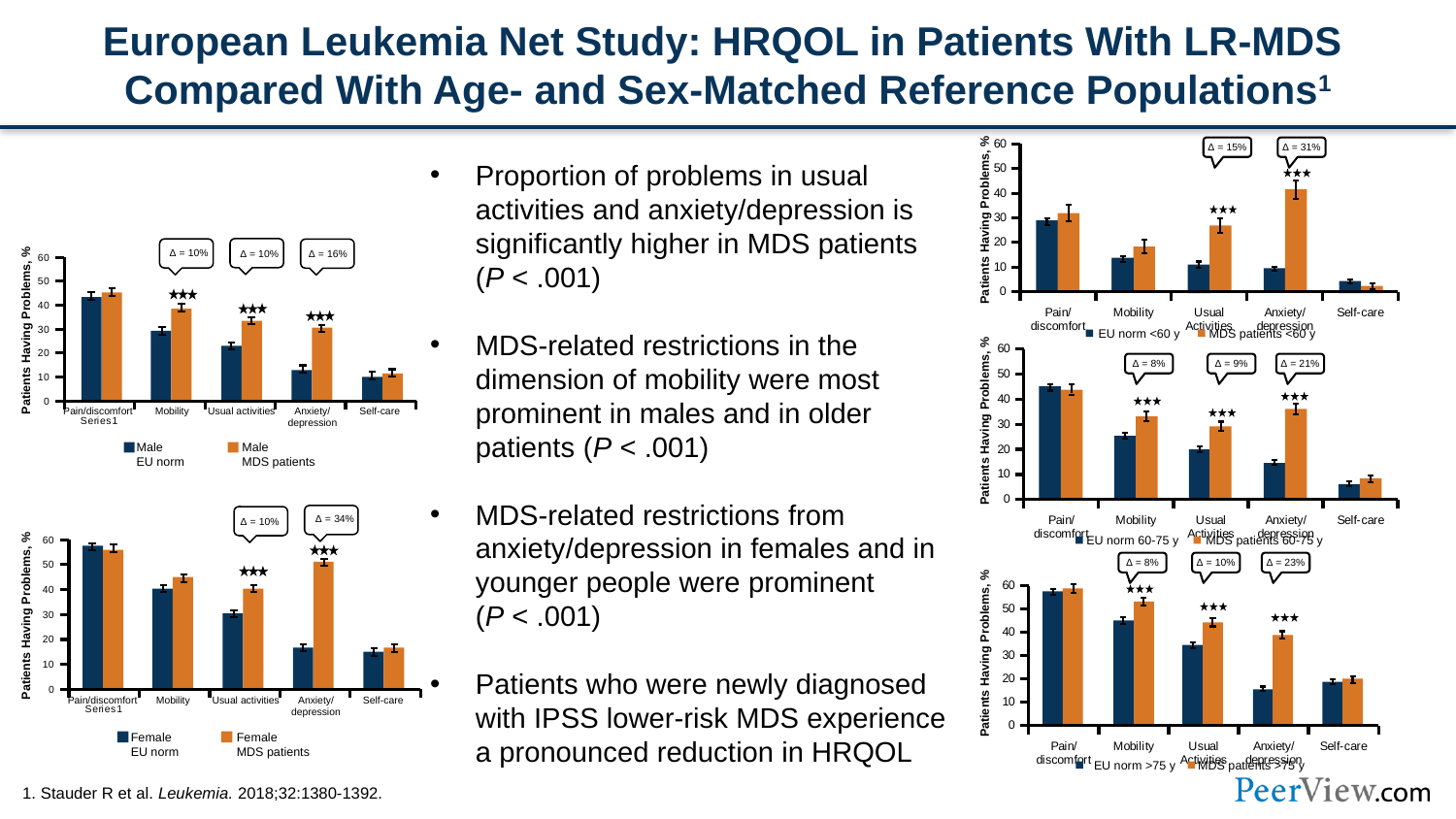
In the top-left chart (Male), is the value for Male MDS patients in Usual activities greater or less than 20? greater In the bottom-left chart (Female), which is larger for Usual activities: Female EU norm or Female MDS patients? Female MDS patients In the bottom-right chart (>75 y), which category has the highest value for EU norm >75 y? Pain/discomfort In the bottom-left chart (Female), what Δ value is annotated above the Anxiety/depression bars? Δ = 34% In the bottom-right chart (>75 y), is the value for EU norm >75 y in Pain/discomfort greater or less than 50? greater In the top-right chart (<60 y), what Δ value is annotated above the Anxiety/depression bars? Δ = 31% In the top-left chart (Male), which category has the highest value for Male MDS patients? Pain/discomfort In the top-left chart (Male), how many series does the legend list? 2 In the middle-right chart (60-75 y), which category has the lowest value for MDS patients 60-75 y? Self-care What type of chart is the top-left chart (Male EU norm vs Male MDS patients)? bar chart In the bottom-left chart (Female), is the value for Female MDS patients in Anxiety/depression greater or less than 40? greater In the top-left chart (Male), how many categories are shown on the x axis? 5